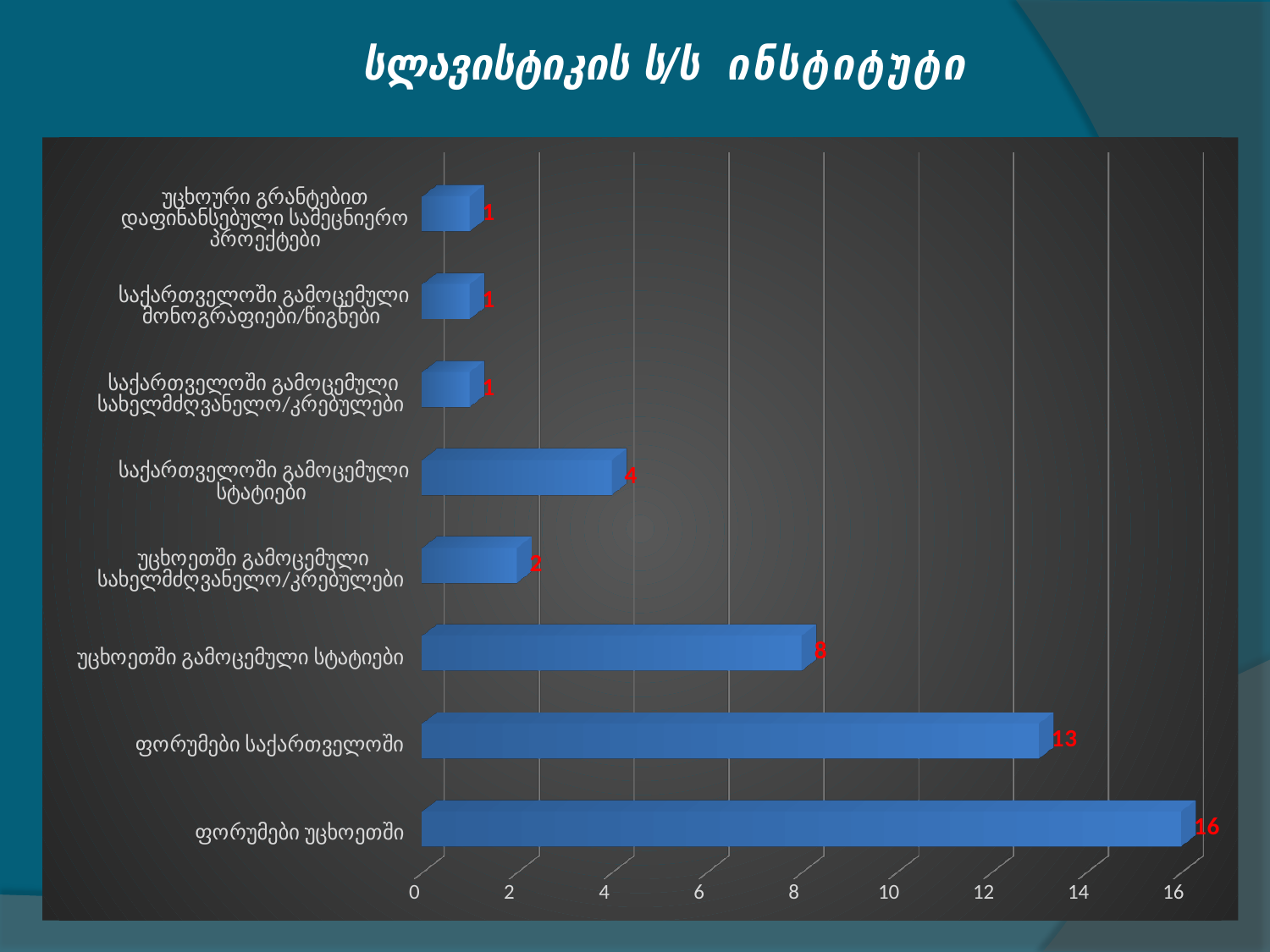
How many categories are shown in the chart? 8 What is the title of the slide? სლავისტიკის ს/ს ინსტიტუტი What kind of chart is shown on the slide? bar chart What is the difference between the values for ფორუმები უცხოეთში and ფორუმები საქართველოში? 3 What is the value for საქართველოში გამოცემული სტატიები? 4 Which category has the highest value? ფორუმები უცხოეთში What is the value for ფორუმები საქართველოში? 13 What is the value for უცხოეთში გამოცემული სახელმძღვანელო/კრებულები? 2 What is the value for უცხოეთში გამოცემული სტატიები? 8 What is the difference between the values for უცხოეთში გამოცემული სტატიები and საქართველოში გამოცემული სტატიები? 4 Which is larger: the value for უცხოეთში გამოცემული სტატიები or the value for საქართველოში გამოცემული სტატიები? უცხოეთში გამოცემული სტატიები What is the value for ფორუმები უცხოეთში? 16